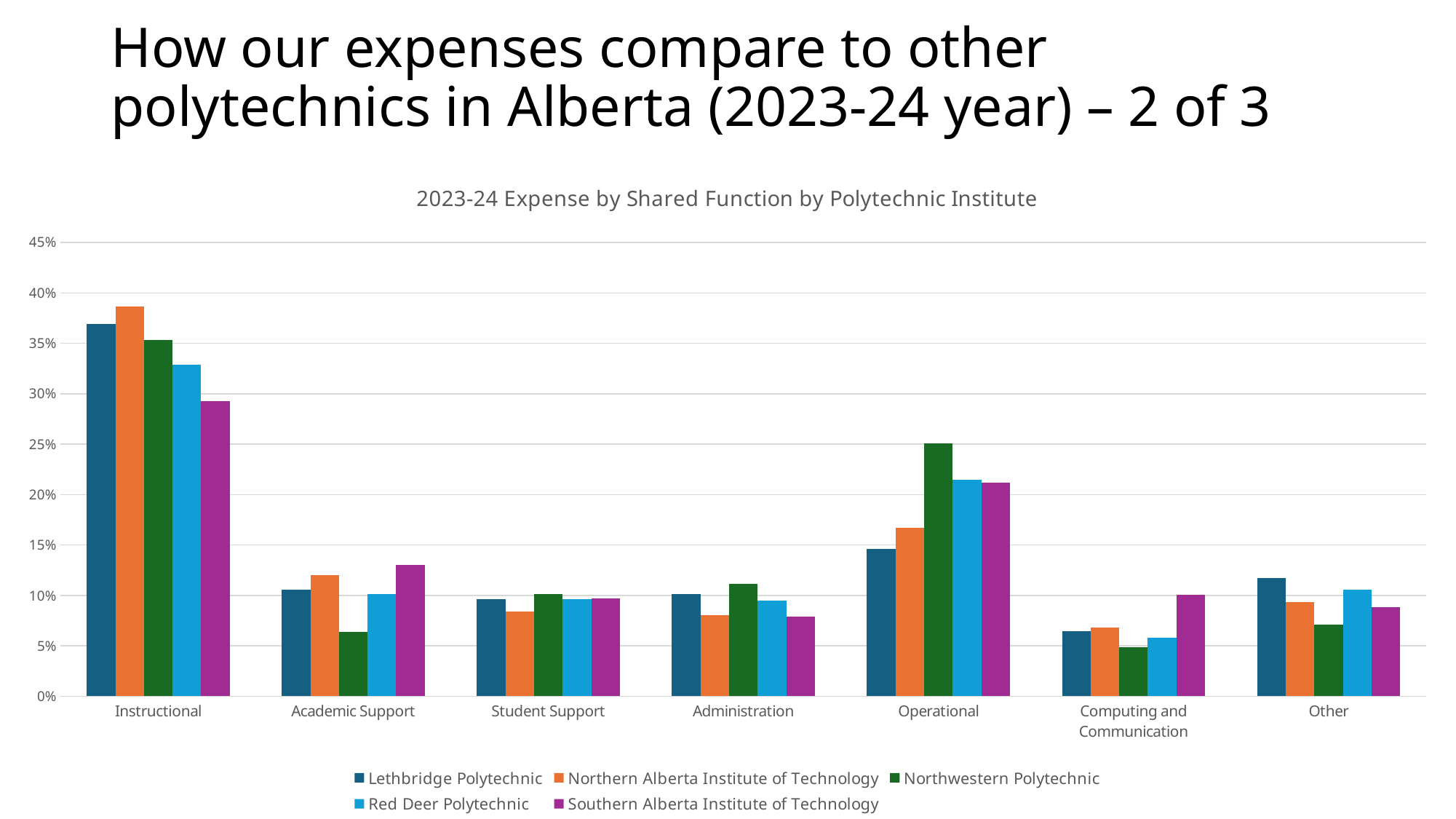
Which institution has the highest Operational expense share? Northwestern Polytechnic Is the Instructional value for Lethbridge Polytechnic greater or less than 35%? greater What kind of chart is shown on the slide? bar chart Which institution has the lowest Instructional expense share? Southern Alberta Institute of Technology How many institutions does the legend list? 5 How many expense function categories are shown on the x axis? 7 In the Computing and Communication category, which is larger: Southern Alberta Institute of Technology or Northwestern Polytechnic? Southern Alberta Institute of Technology Is the Instructional value for Southern Alberta Institute of Technology greater or less than 30%? less Is the Operational value for Northern Alberta Institute of Technology greater or less than 15%? greater Which institution has the lowest Academic Support expense share? Northwestern Polytechnic Which institution has the highest Instructional expense share? Northern Alberta Institute of Technology What is the title of the chart? 2023-24 Expense by Shared Function by Polytechnic Institute